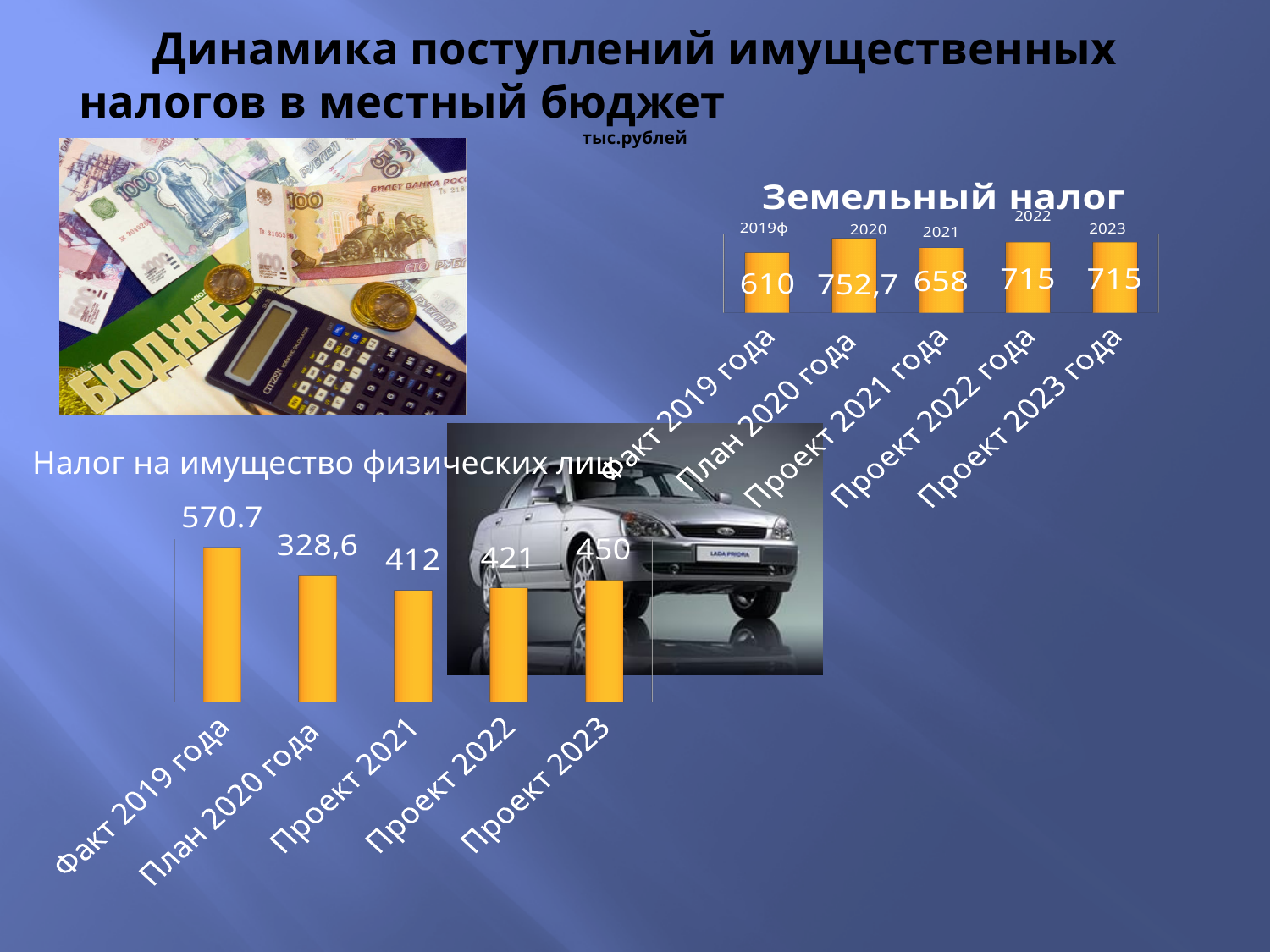
In the 'Налог на имущество физических лиц' chart, which is larger: the value for Проект 2023 or the value for Проект 2021? Проект 2023 In the 'Земельный налог' chart, which category has the lowest value? Факт 2019 года In the 'Налог на имущество физических лиц' chart, what is the value for Факт 2019 года? 570.7 How many categories are shown in the 'Земельный налог' chart? 5 In the 'Земельный налог' chart, what is the value for Факт 2019 года? 610 In the 'Налог на имущество физических лиц' chart, what is the value for План 2020 года? 328,6 In the 'Налог на имущество физических лиц' chart, what is the difference between the values for Проект 2023 and Проект 2022? 29 What type of chart is the 'Налог на имущество физических лиц' chart? Bar chart In the 'Земельный налог' chart, what is the value for План 2020 года? 752,7 In the 'Земельный налог' chart, which category has the highest value? План 2020 года In the 'Земельный налог' chart, what is the difference between the values for Проект 2022 года and Проект 2021 года? 57